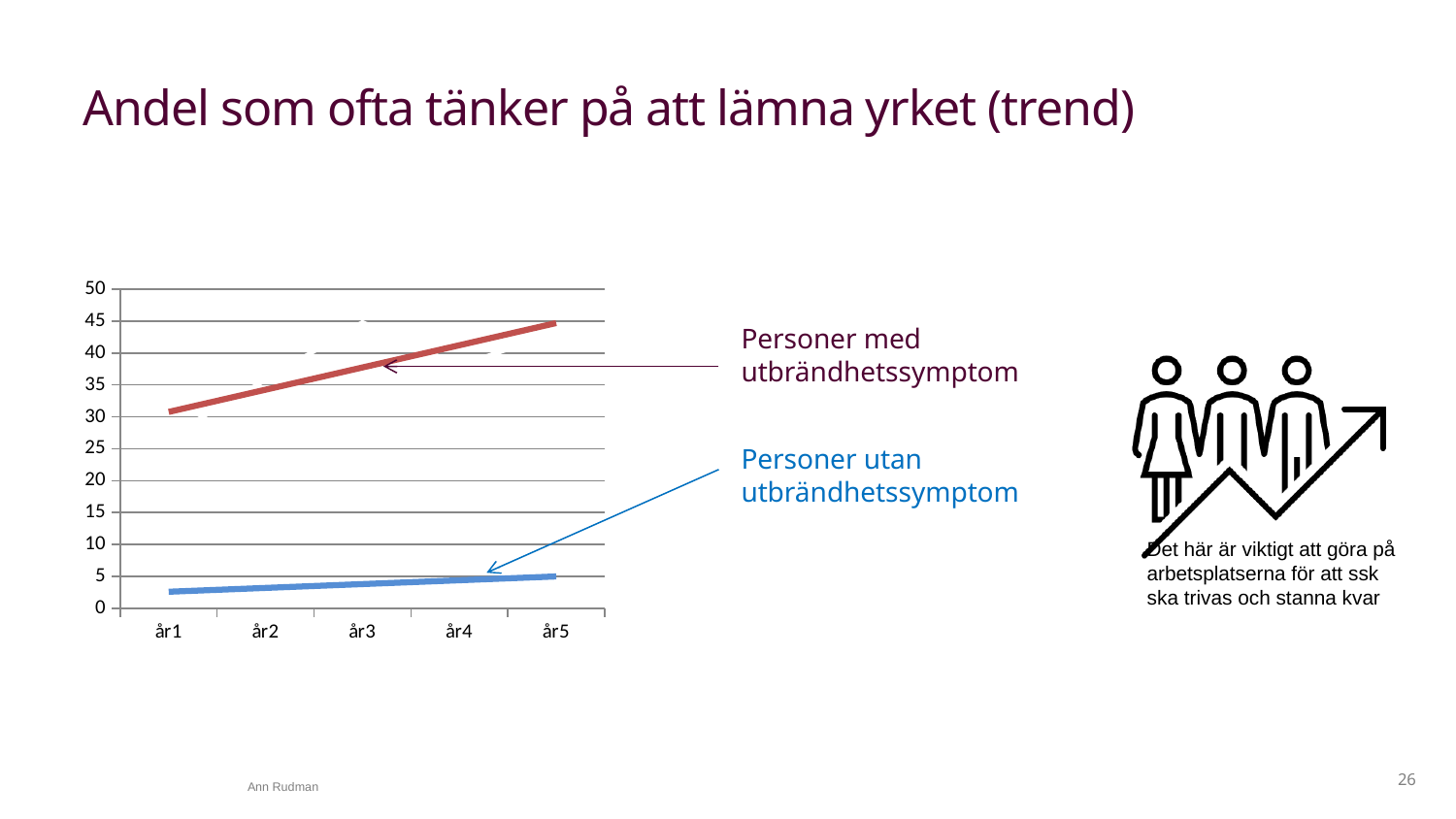
Is the value for Personer utan utbrändhetssymptom at år5 greater or less than 10? less At år5, which series has the larger value, Personer med utbrändhetssymptom or Personer utan utbrändhetssymptom? Personer med utbrändhetssymptom What kind of chart is shown on the slide? line chart Which colour is used for the line labelled Personer utan utbrändhetssymptom? blue How many series are plotted in the chart? 2 Does the line for Personer utan utbrändhetssymptom rise or fall from år1 to år5? rise Is the value for Personer med utbrändhetssymptom at år1 greater or less than 35? less How many points (years) are shown along the x axis? 5 Does the line for Personer med utbrändhetssymptom rise or fall from år1 to år5? rise Is the value for Personer med utbrändhetssymptom at år5 greater or less than 40? greater What is the title of the slide containing the chart? Andel som ofta tänker på att lämna yrket (trend)